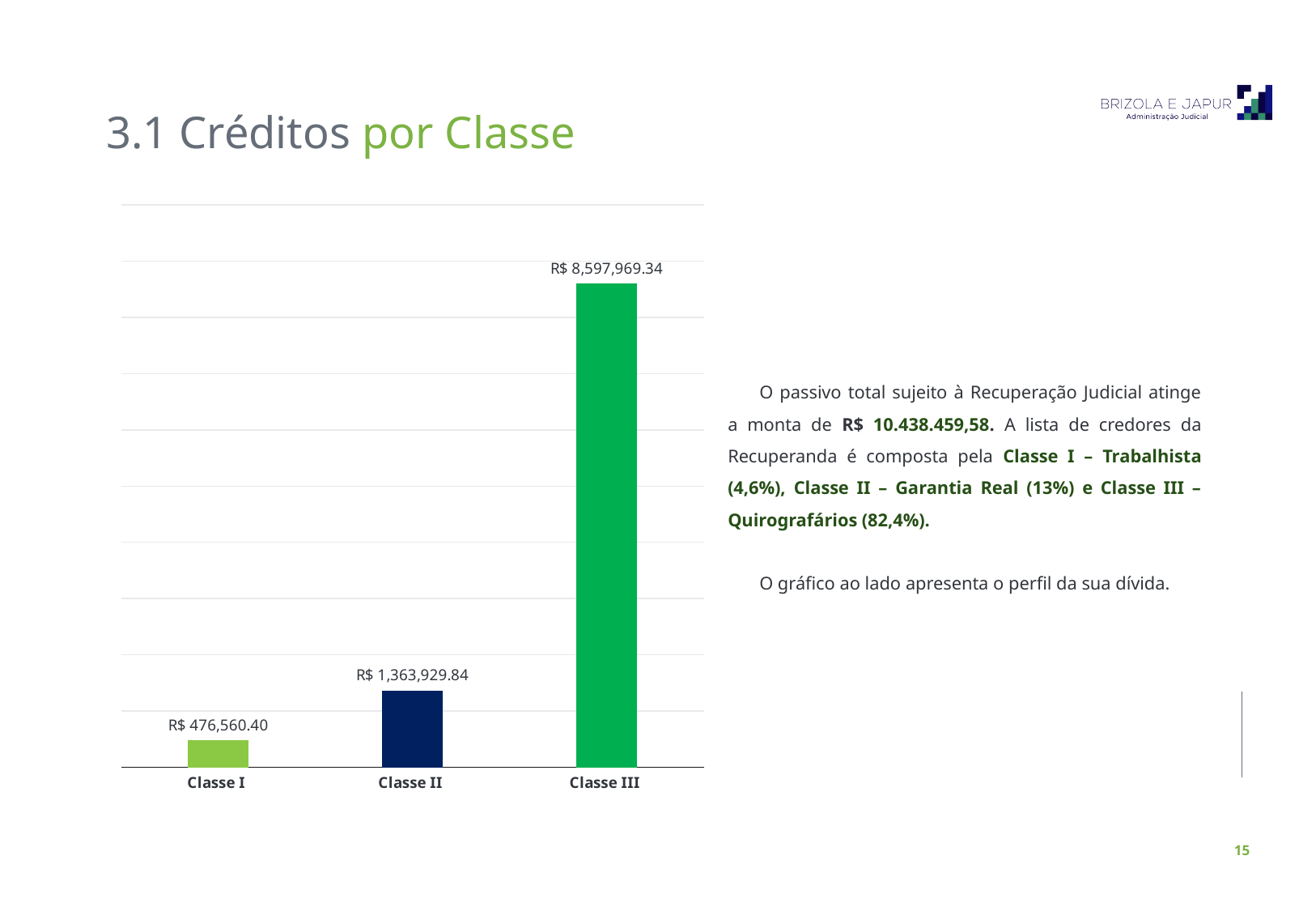
Which is larger, the value for Classe I or the value for Classe II? Classe II What is the difference between the values for Classe II and Classe I? R$ 887,369.44 What is the difference between the values for Classe III and Classe II? R$ 7,234,039.50 Which class has the highest value? Classe III What is the value for Classe I? R$ 476,560.40 What colour is the bar for Classe II? Dark blue What kind of chart is shown on the slide? Bar chart Do the values rise or fall from Classe I to Classe III? Rise What is the value for Classe II? R$ 1,363,929.84 How many classes are shown in the chart? 3 Which class has the lowest value? Classe I What is the value for Classe III? R$ 8,597,969.34